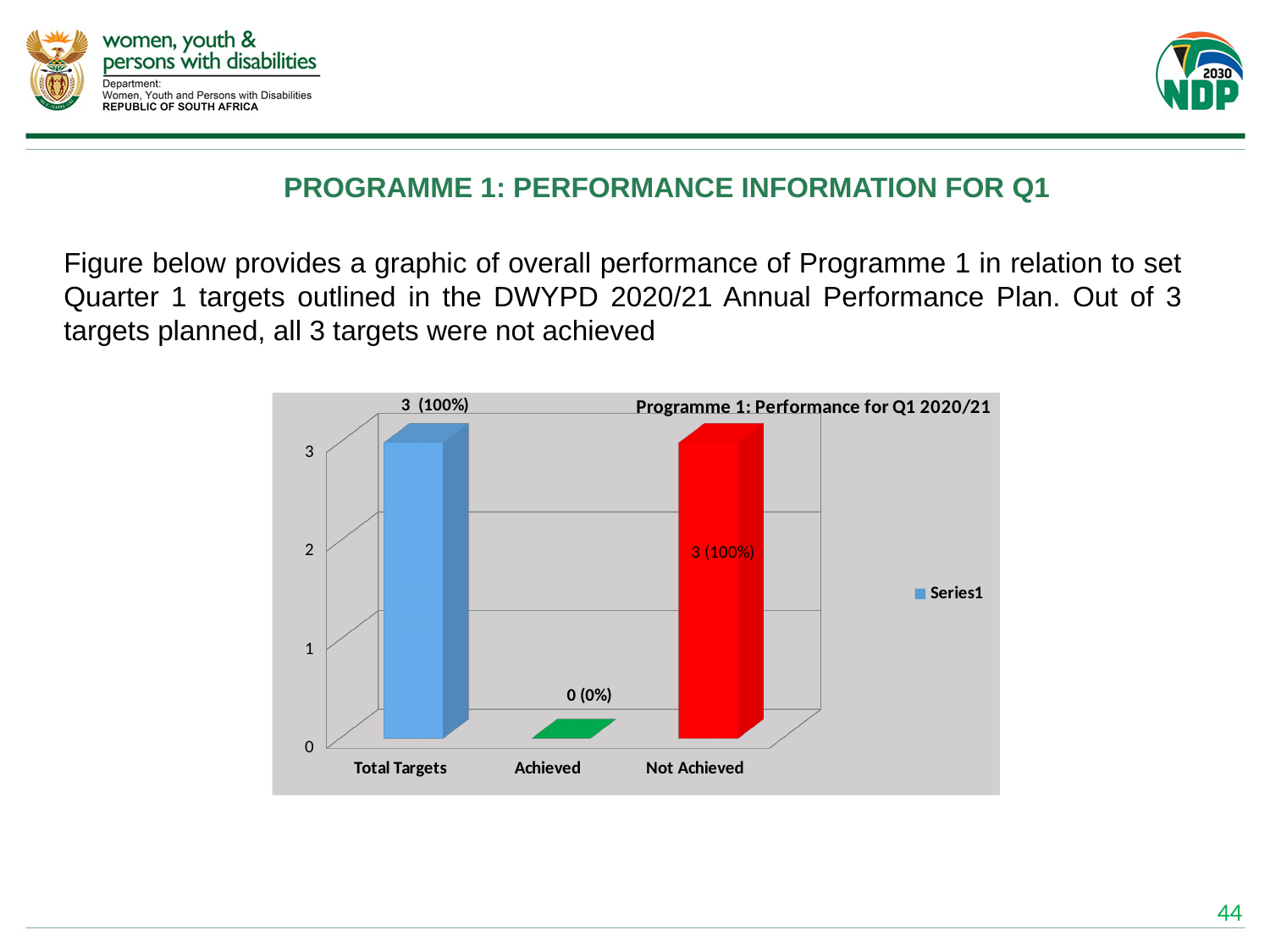
What colour is the Not Achieved bar? Red What is the value shown for Total Targets? 3 (100%) How many categories are shown on the x axis? 3 Is the value for Not Achieved greater or less than 2? greater What kind of chart is shown? Bar chart How many series does the legend list? 1 What is the title of the chart? Programme 1: Performance for Q1 2020/21 Which category has the lowest value? Achieved What is the difference between the Total Targets value and the Achieved value? 3 What is the value shown for Achieved? 0 (0%) Which is larger, the value for Not Achieved or the value for Achieved? Not Achieved What is the value shown for Not Achieved? 3 (100%)